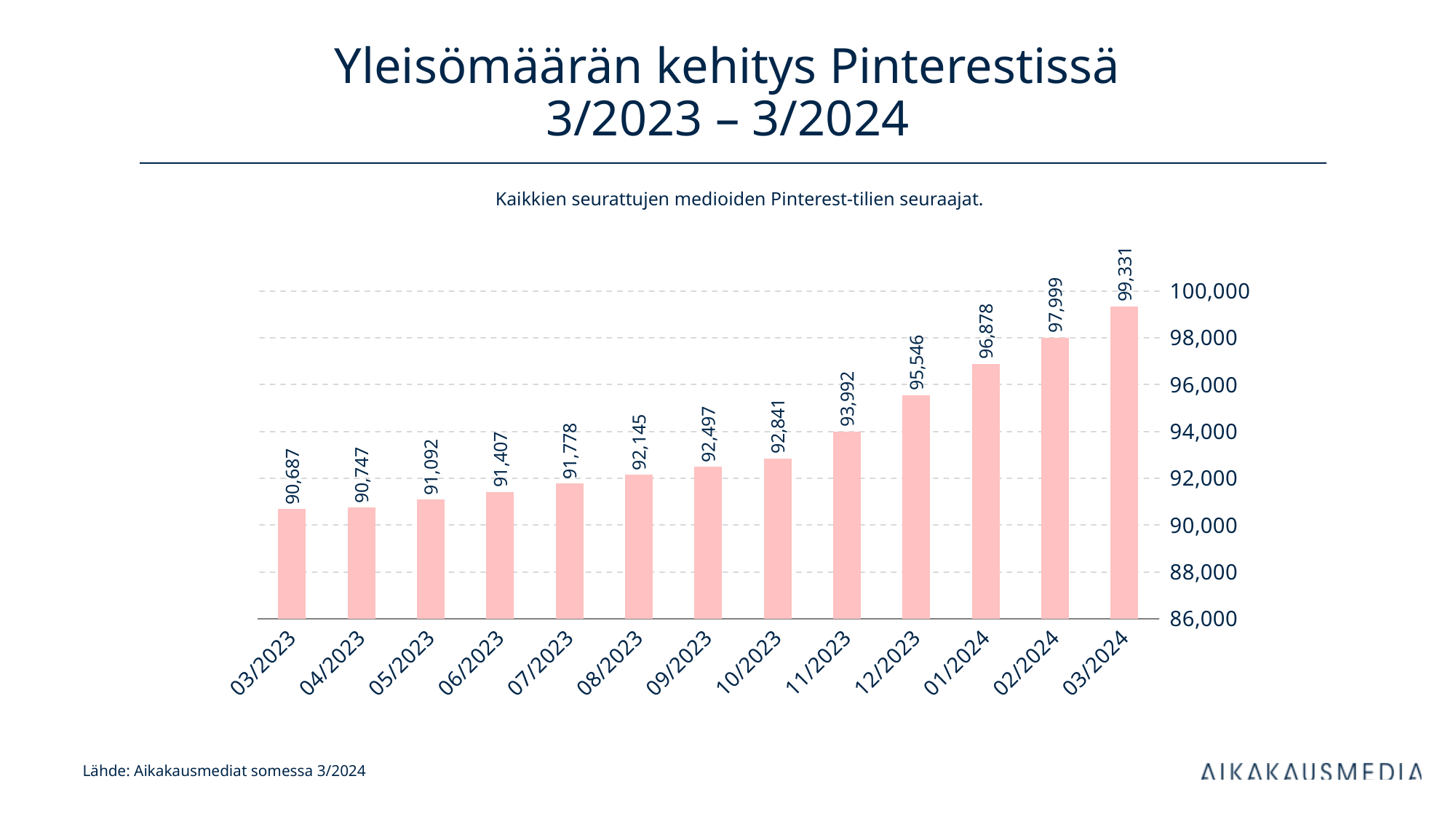
Which is larger, the value for 09/2023 or the value for 11/2023? 11/2023 What is the value for 12/2023? 95,546 Which month has the lowest value? 03/2023 What kind of chart is shown on the slide? bar chart Which month has the highest value? 03/2024 What is the value for 03/2023? 90,687 How many months are shown on the x axis? 13 Do the values rise or fall from 03/2023 to 03/2024? rise What is the difference between the values for 03/2024 and 03/2023? 8,644 Is the value for 10/2023 greater or less than 94,000? less What is the value for 03/2024? 99,331 What is the difference between the values for 02/2024 and 01/2024? 1,121